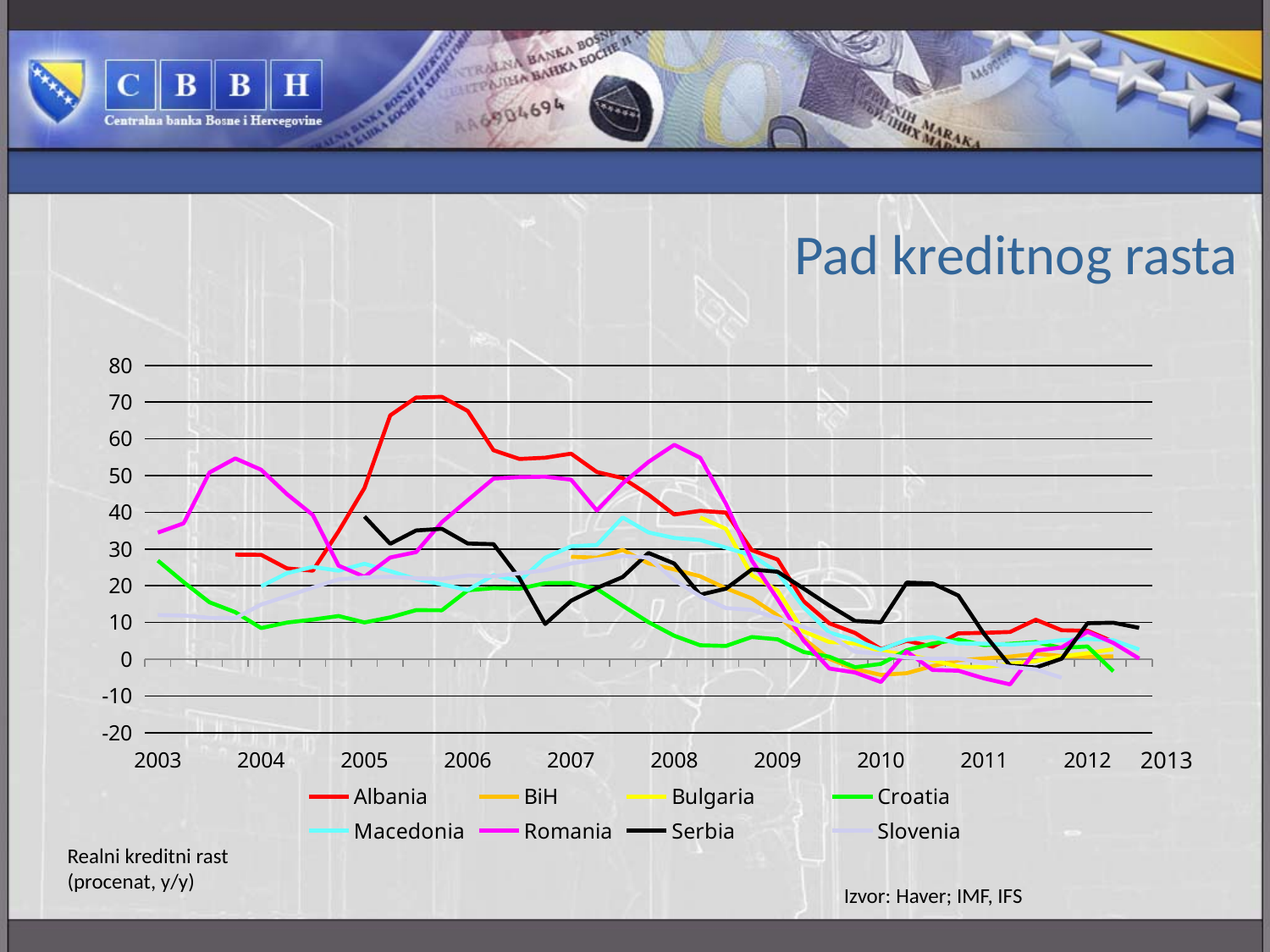
Which series is drawn in black? Serbia Does the Croatia line generally rise or fall between 2008 and 2010? fall In mid-2005, which line is higher, Albania or Croatia? Albania Does the Albania line generally rise or fall between 2006 and 2010? fall Is the value for Serbia at the start of 2005 greater or less than 30? greater How many series does the legend list? 8 How many year labels are shown on the x axis? 11 Which country's line reaches the highest value anywhere on the chart? Albania Is the peak value of the Albania line greater or less than 60? greater What kind of chart is shown on the slide? line chart Is the lowest value of the Romania line, around 2010, greater or less than 0? less What is the title of the slide's chart? Pad kreditnog rasta